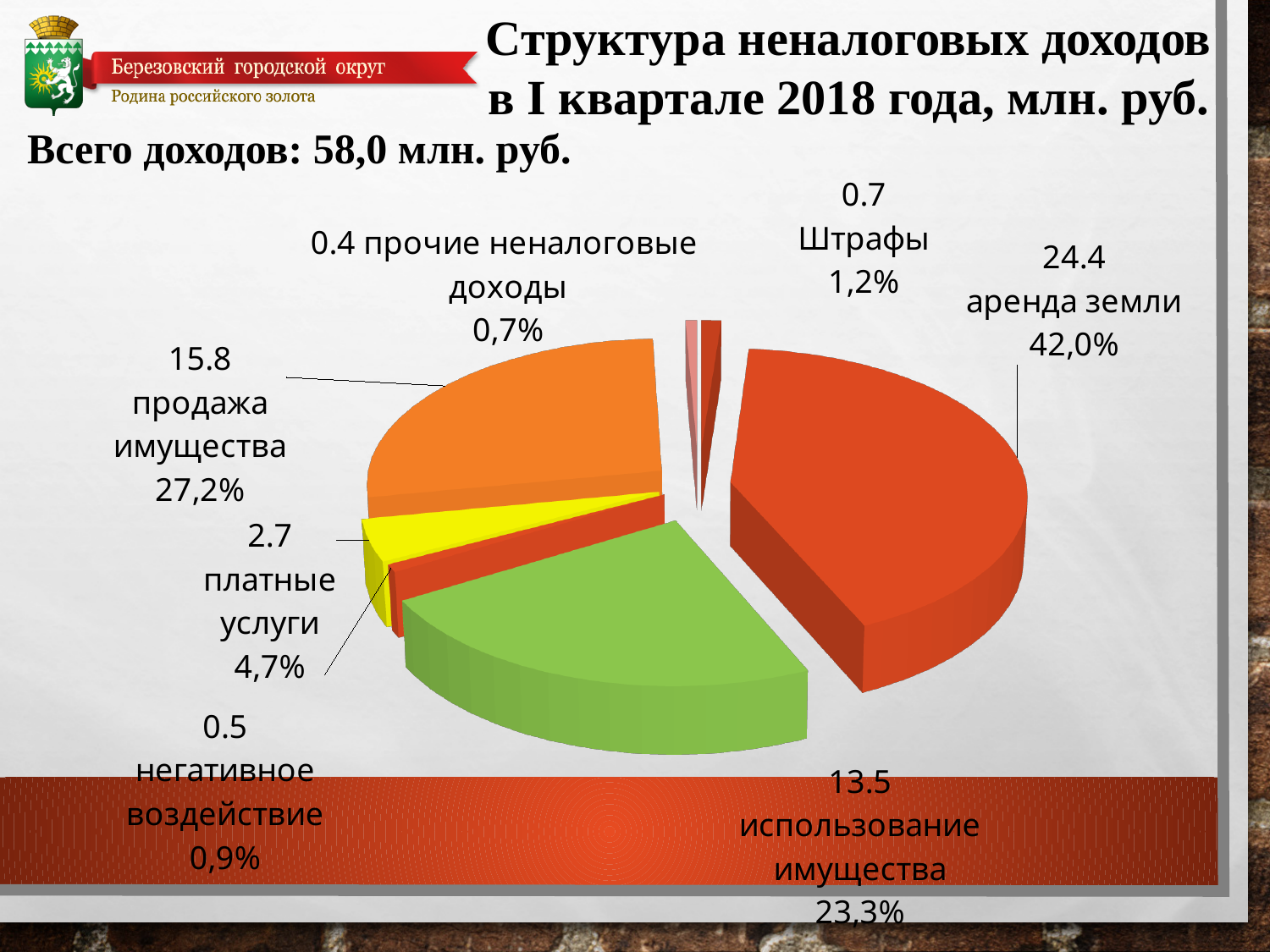
What share of the pie does Штрафы represent? 1,2% What is the value for аренда земли? 24.4 What is the value for платные услуги? 2.7 What kind of chart is shown on the slide? pie chart What share of the pie does продажа имущества represent? 27,2% Which category has the largest slice? аренда земли What is the value for использование имущества? 13.5 How many slices does the pie chart have? 7 What is the difference between the values for аренда земли and продажа имущества? 8.6 What is the title of the chart? Структура неналоговых доходов в I квартале 2018 года, млн. руб. Which is larger, the value for использование имущества or the value for продажа имущества? продажа имущества Which category has the smallest slice? прочие неналоговые доходы